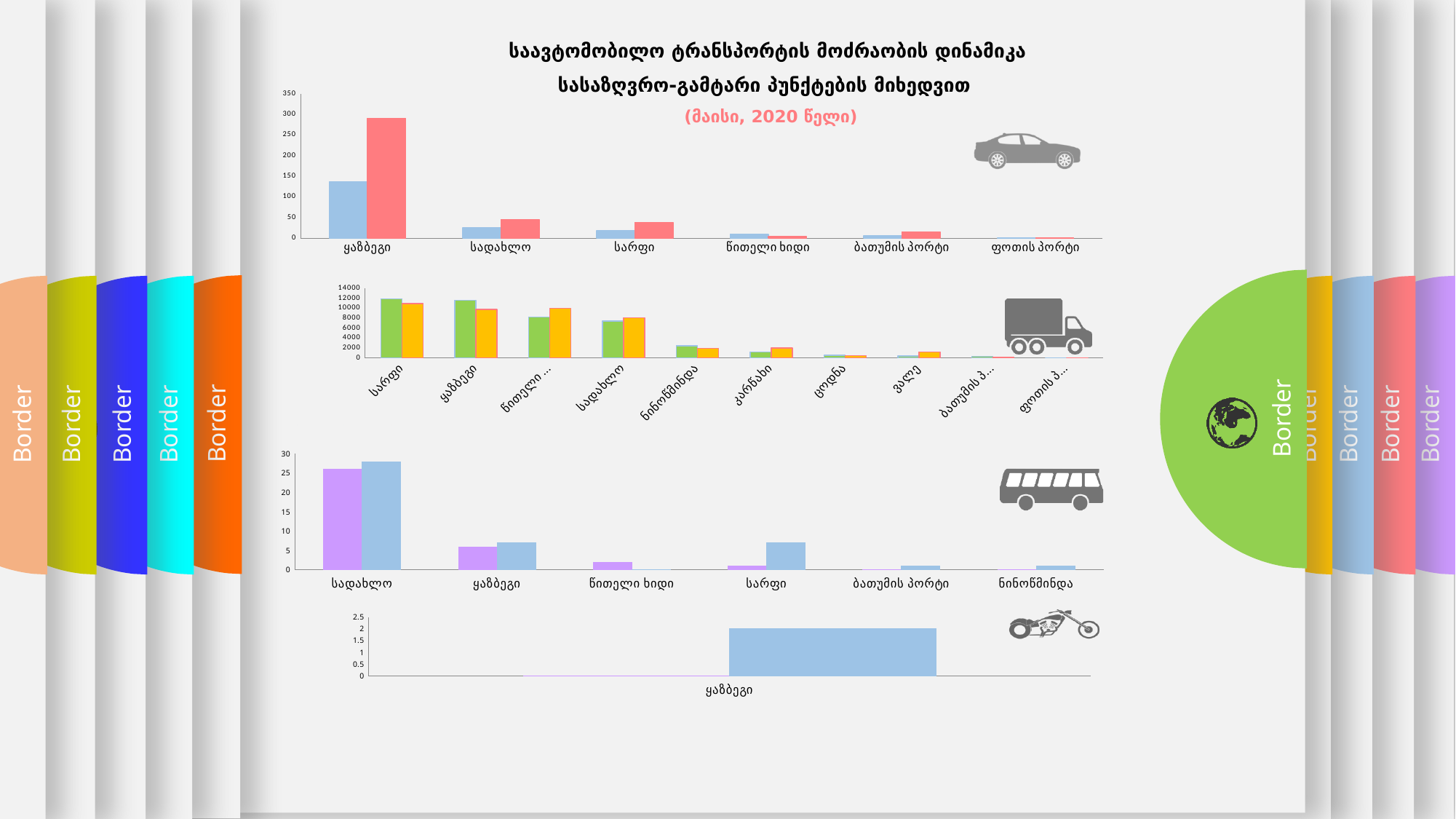
In the top chart (with the car icon), is the red bar for ყაზბეგი greater or less than 250? greater In the top chart (with the car icon), which has the taller blue bar, სადახლო or წითელი ხიდი? სადახლო In the second chart (with the truck icon), is the green bar for სარფი greater or less than 10000? greater In the third chart (with the bus icon), is the purple bar for ყაზბეგი greater or less than 10? less In the second chart (with the truck icon), how many categories are shown on the x axis? 10 In the top chart (with the car icon), how many categories are shown on the x axis? 6 In the third chart (with the bus icon), which category has the tallest blue bar? სადახლო What kind of chart is the top chart (with the car icon)? bar chart In the top chart (with the car icon), which category has the tallest red bar? ყაზბეგი In the bottom chart (with the motorcycle icon), how many categories are shown on the x axis? 1